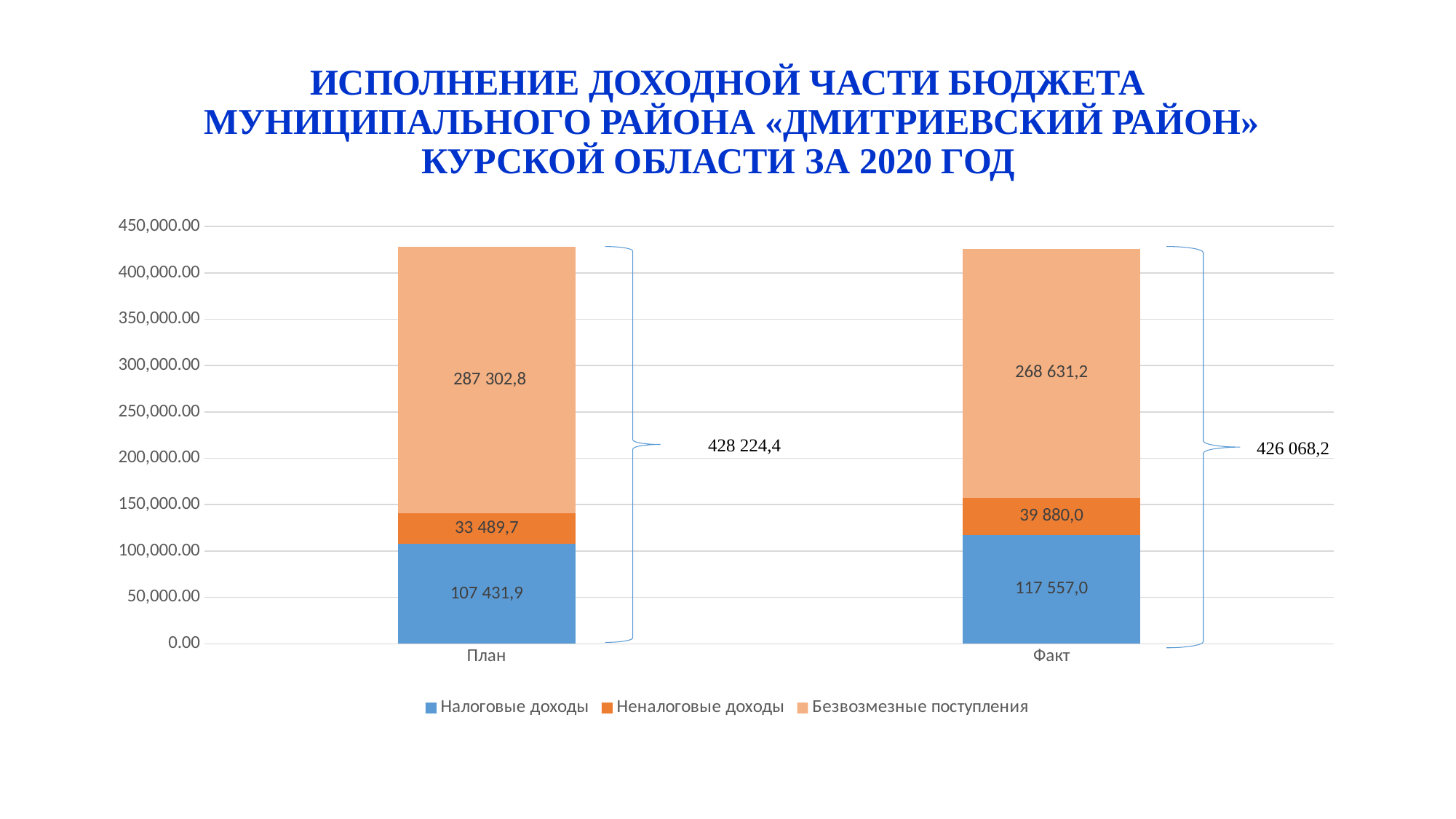
What is the value of Безвозмезные поступления for План? 287 302,8 How many series does the legend list? 3 Which series has the largest value in the План bar? Безвозмезные поступления What is the value of Неналоговые доходы for Факт? 39 880,0 What kind of chart is shown on the slide? Stacked bar chart What is the value of Безвозмезные поступления for Факт? 268 631,2 Is the value of Налоговые доходы larger for План or for Факт? Факт What is the difference between the Безвозмезные поступления values for План and Факт? 18 671,6 What is the total of the stacked bar for Факт? 426 068,2 What is the value of Налоговые доходы for План? 107 431,9 What is the total of the stacked bar for План? 428 224,4 What is the difference between the Налоговые доходы values for Факт and План? 10 125,1